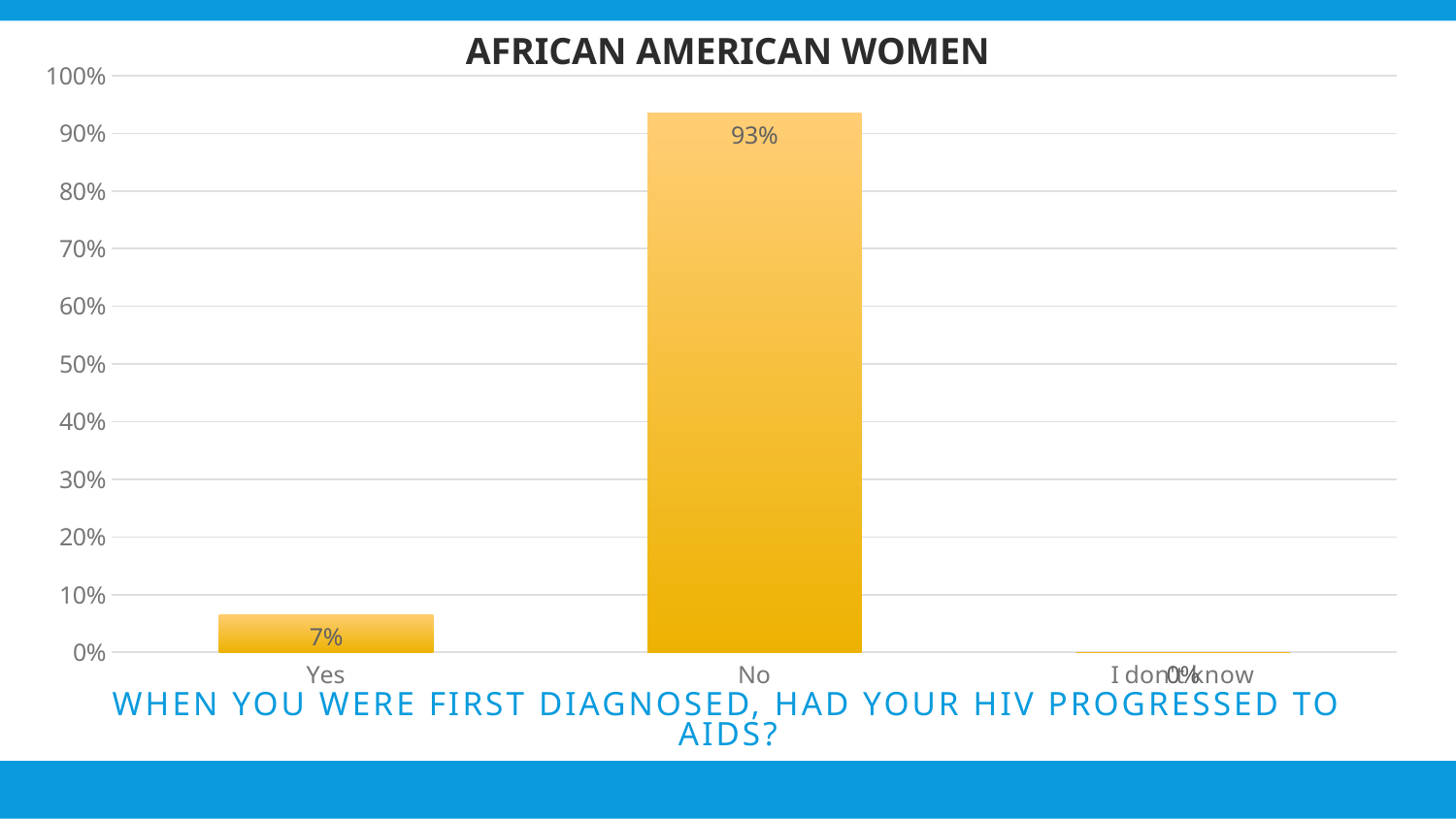
What kind of chart is shown on the slide? Bar chart Is the value for "Yes" greater or less than 10%? less Which is larger, the value for "Yes" or the value for "No"? No How many response categories are shown on the x axis? 3 Which response category has the lowest value? I don't know What is the difference between the "No" and "Yes" percentages? 86% Which response category has the highest value? No What is the title of the chart? AFRICAN AMERICAN WOMEN Is the value for "No" greater or less than 50%? greater What percentage of African American women answered "I don't know"? 0% What percentage of African American women answered "Yes"? 7% What percentage of African American women answered "No"? 93%